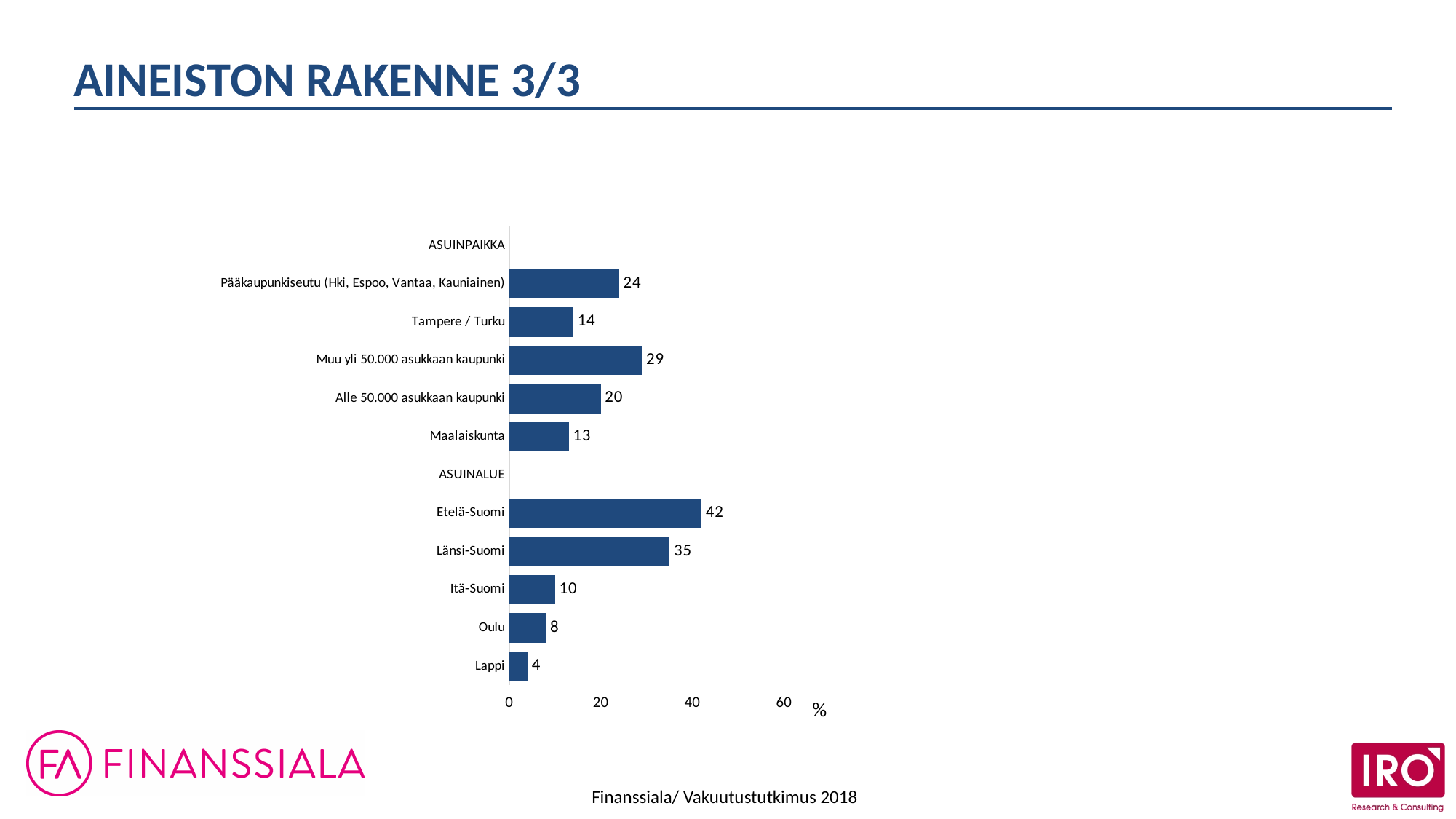
How many bars are plotted in the chart? 10 What is the value for Lappi? 4 What is the value for Muu yli 50.000 asukkaan kaupunki? 29 Which category has the lowest value in the chart? Lappi Which is larger, the value for Tampere / Turku or the value for Maalaiskunta? Tampere / Turku Is the value for Länsi-Suomi greater or less than 20? greater What kind of chart is shown on the slide? Bar chart Which category has the highest value in the chart? Etelä-Suomi What is the value for Pääkaupunkiseutu (Hki, Espoo, Vantaa, Kauniainen)? 24 What is the difference between the values for Alle 50.000 asukkaan kaupunki and Itä-Suomi? 10 What unit is shown at the end of the horizontal axis? % What is the difference between the values for Etelä-Suomi and Länsi-Suomi? 7